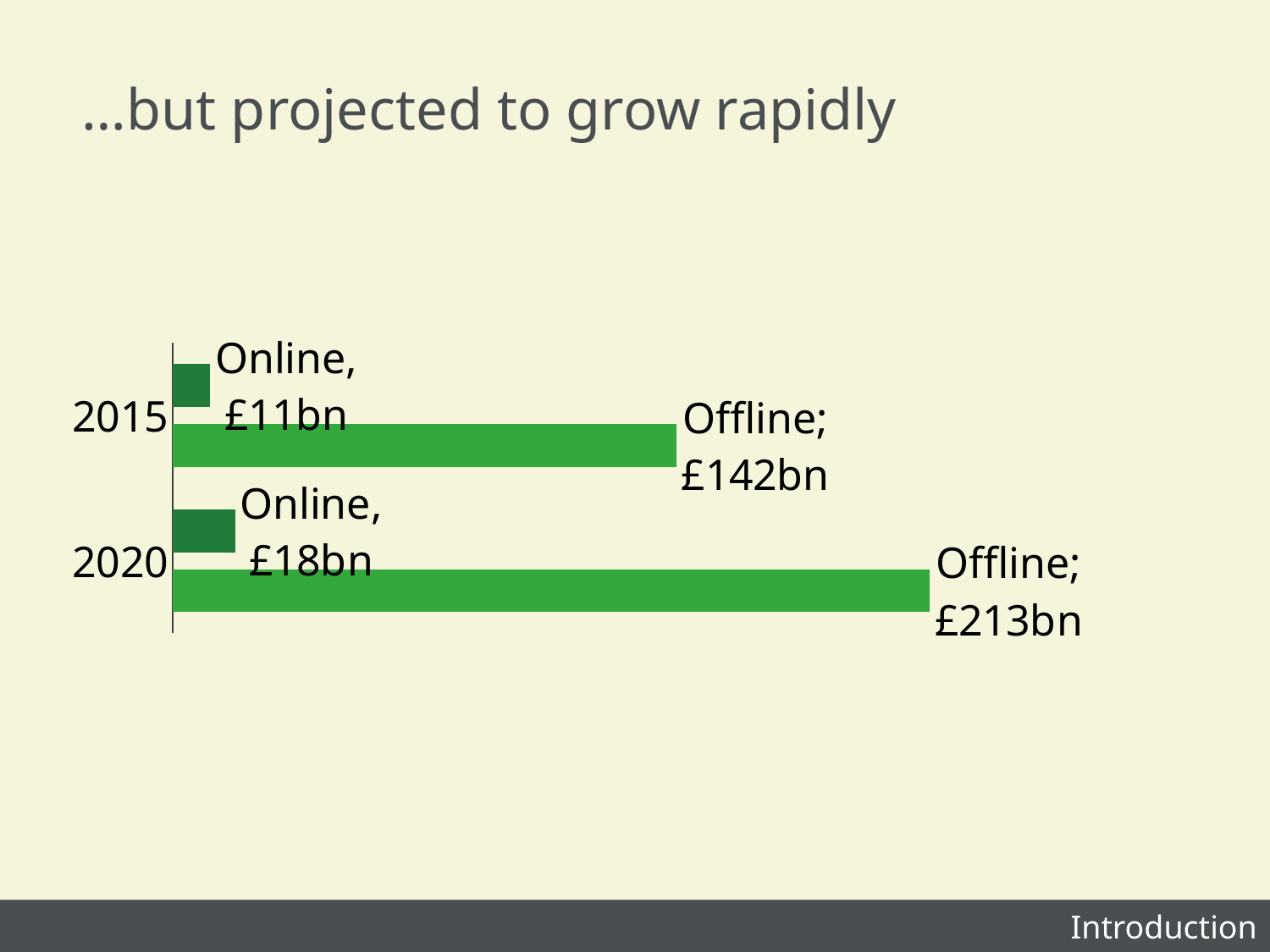
By how much does the Online value increase from 2015 to 2020? £7bn Which is larger in 2020, the Online value or the Offline value? Offline How many years are shown on the chart? 2 What is the Online value for 2020? £18bn What is the Offline value for 2020? £213bn What is the Online value for 2015? £11bn Which bar has the lowest value on the chart? Online, 2015 What kind of chart is shown on the slide? Bar chart By how much does the Offline value increase from 2015 to 2020? £71bn What is the Offline value for 2015? £142bn Which bar has the highest value on the chart? Offline, 2020 What is the title of the slide? ...but projected to grow rapidly